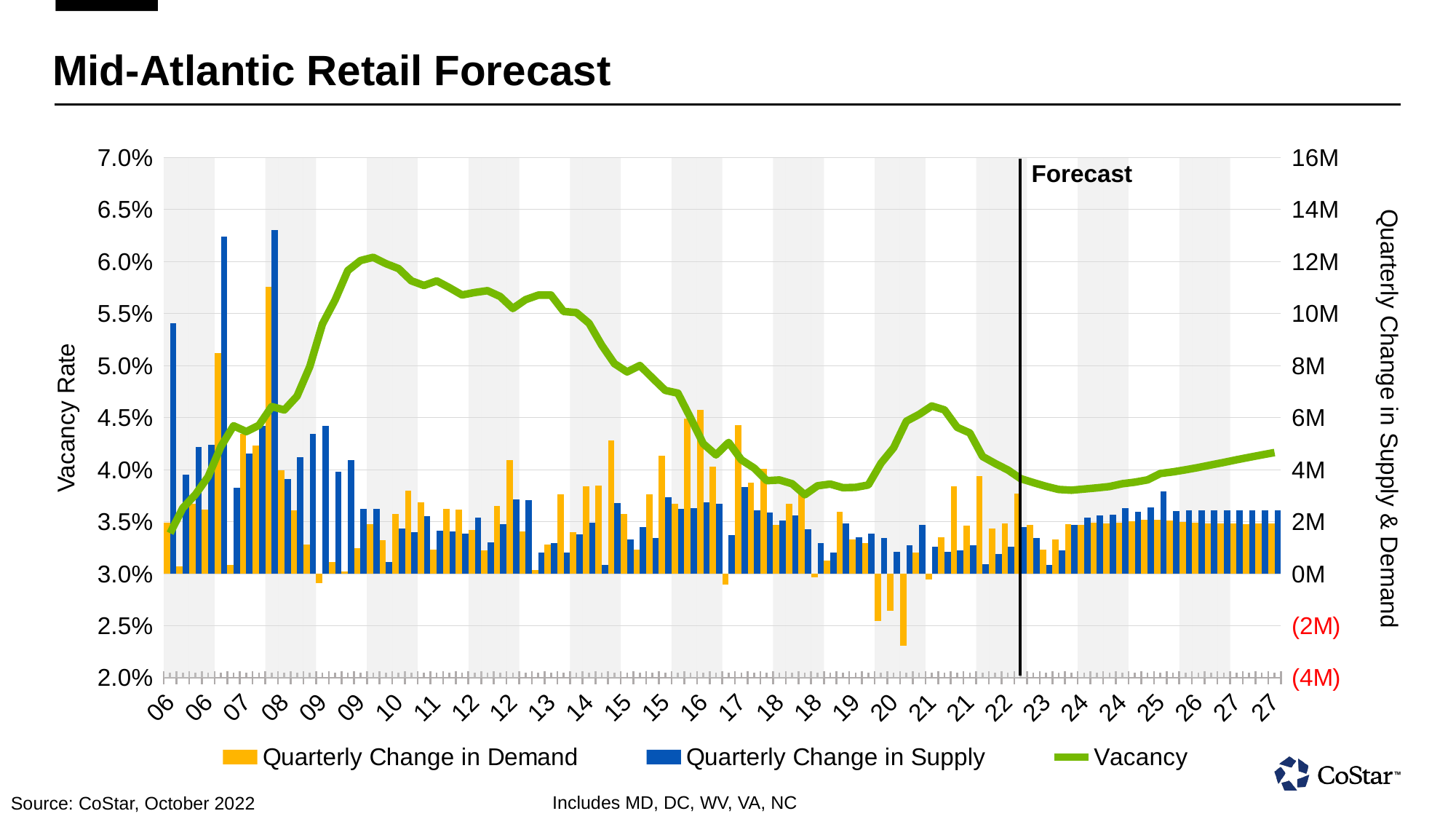
In which year is the Quarterly Change in Demand bar the most negative (lowest)? 20 In which year is the tallest Quarterly Change in Demand bar? 08 Is the Vacancy value around 2010 greater or less than 5.5%? greater Does the Vacancy line rise or fall between 2009 and 2018? fall Does the Vacancy line rise or fall across the forecast period from 2024 to 2027? rise Is the Vacancy value at the end of the forecast (27) greater or less than 4.0%? greater What is the title of the chart? Mid-Atlantic Retail Forecast What kind of chart is shown on the slide? A combination bar and line chart How many series does the legend list? 3 What does the vertical black line on the chart mark? Forecast Is the Vacancy value at its 2018 low greater or less than 4.0%? less